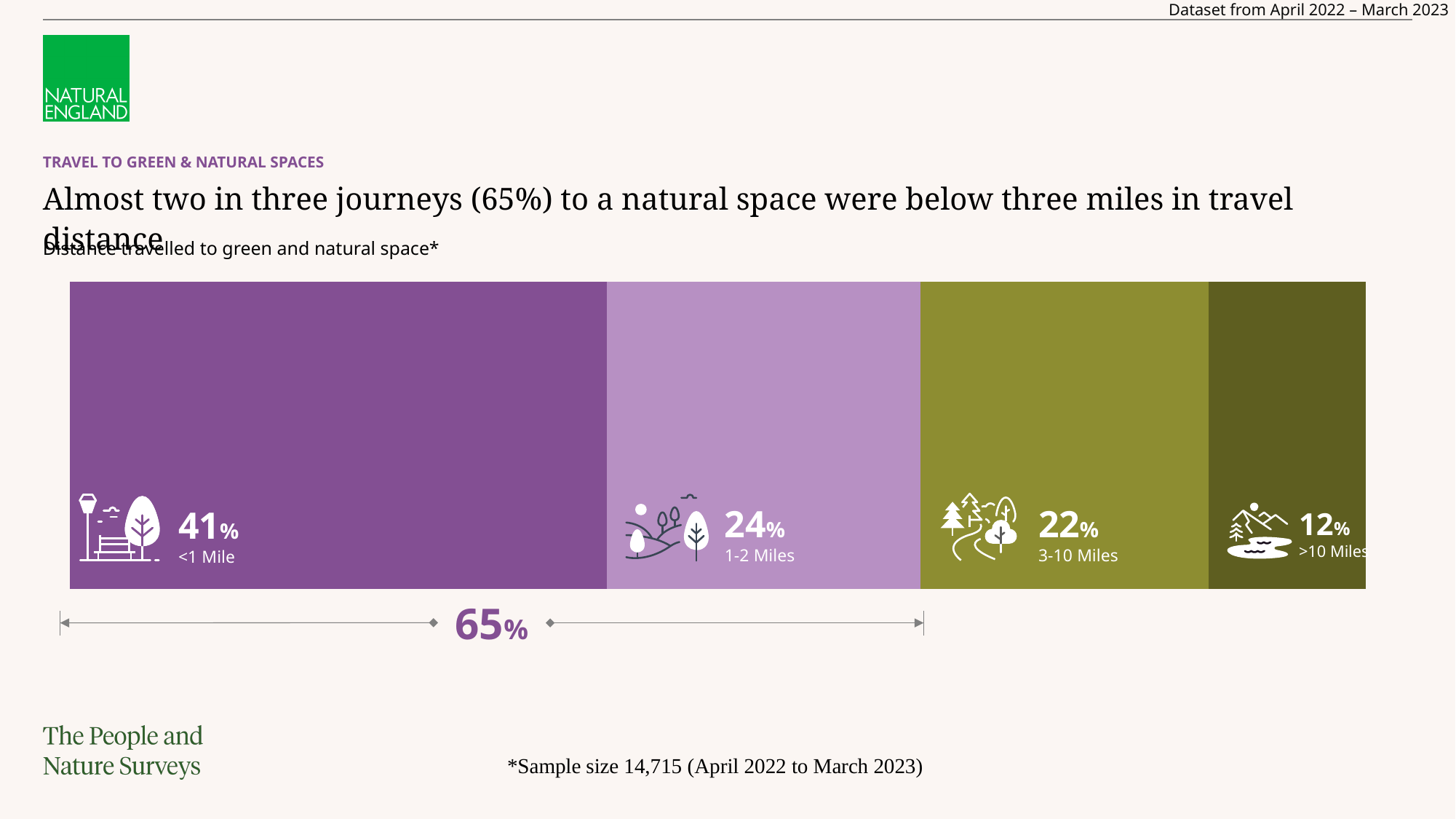
What is the combined percentage for journeys under 3 miles (<1 Mile plus 1-2 Miles)? 65% What is the difference in percentage points between the <1 Mile and >10 Miles categories? 29 What percentage of journeys to green and natural space were less than 1 mile? 41% Which is larger, the share for 1-2 Miles or the share for 3-10 Miles? 1-2 Miles What percentage of journeys were 1-2 miles? 24% What is the title of the chart? Distance travelled to green and natural space* What type of chart is used to show the distance travelled? Stacked bar chart What percentage of journeys were 3-10 miles? 22% How many distance categories are shown in the bar? 4 What percentage of journeys were more than 10 miles? 12% Which distance category has the highest share of journeys? <1 Mile Which distance category has the lowest share of journeys? >10 Miles